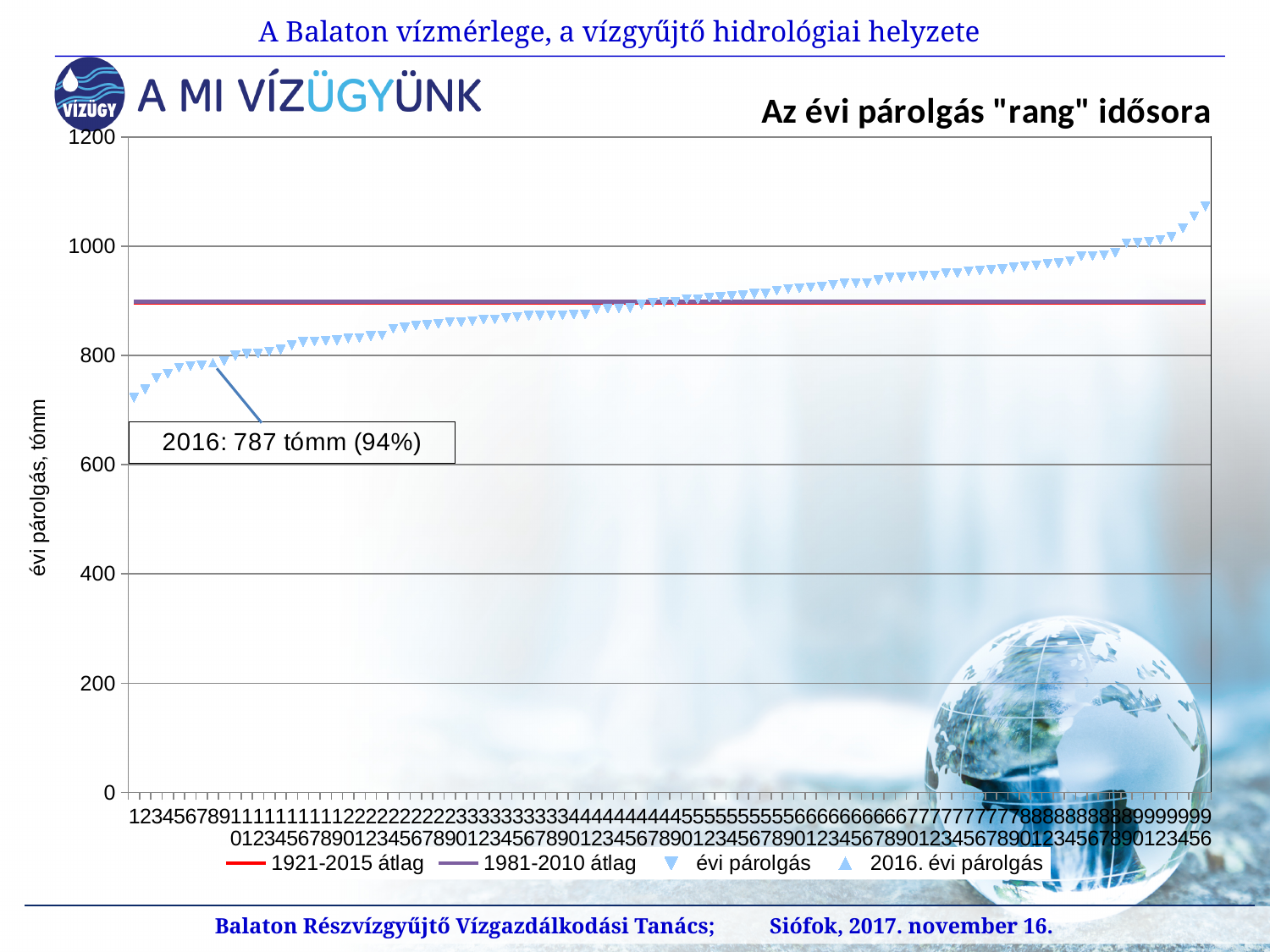
What is the label of the y axis? évi párolgás, tómm What is the annual evaporation value for 2016 shown in the annotation? 787 tómm Is the 1981-2010 átlag line greater or less than 800? greater Is the value of the first (lowest-ranked) point greater or less than 800? less Which is larger: the 2016 evaporation value or the 1981-2010 átlag line? 1981-2010 átlag How many ranked points are shown on the x axis? 96 Is the value of the last (highest-ranked) point greater or less than 1000? greater Do the évi párolgás values rise or fall along the x axis? rise How many series does the chart legend list? 4 What percentage is given for the 2016 evaporation in the annotation? 94% What is the highest tick value shown on the y axis? 1200 What is the title of the chart? Az évi párolgás "rang" idősora